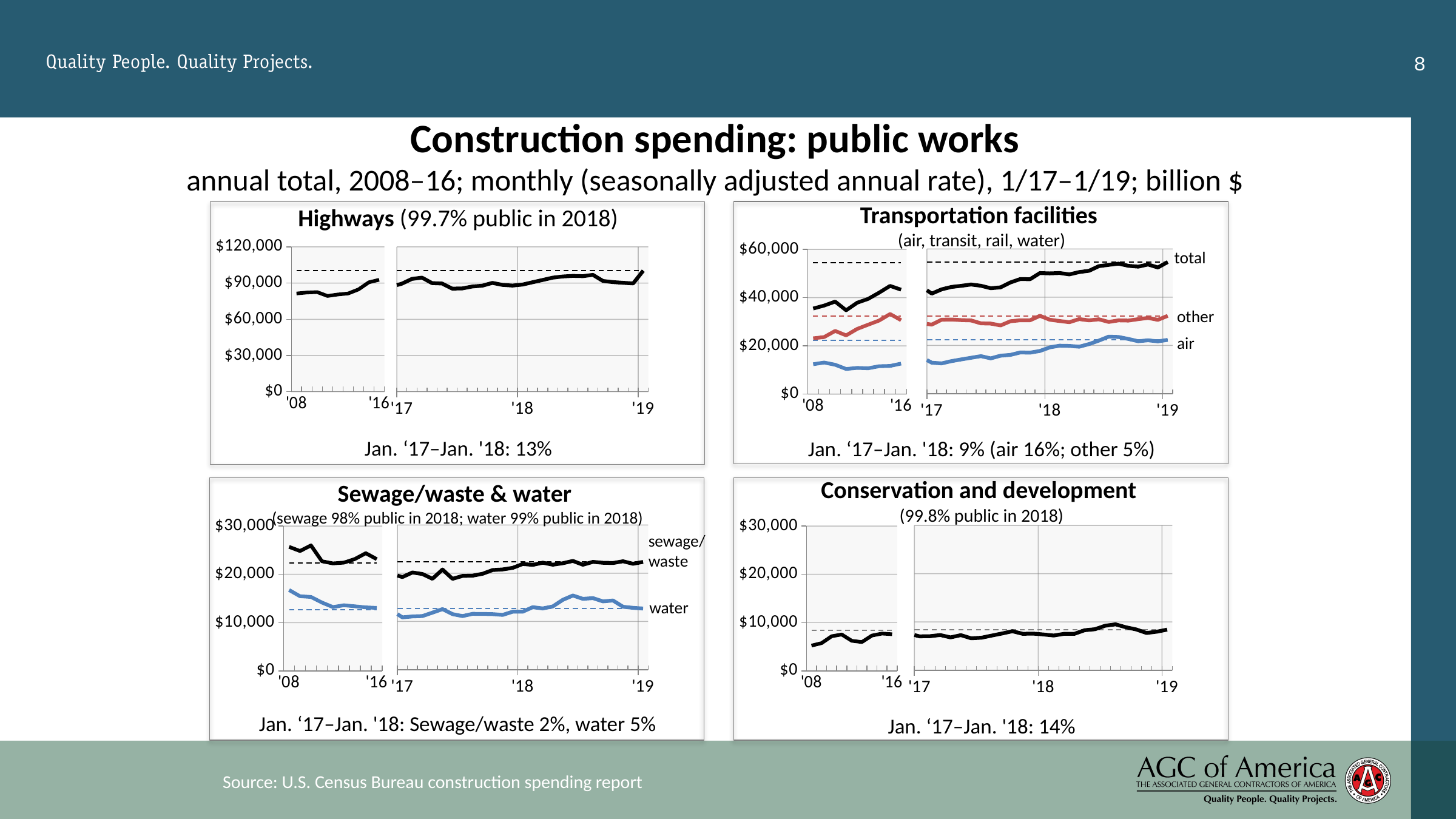
How many series are labelled in the Transportation facilities chart? 3 In the Transportation facilities chart, is the total at Jan. '19 greater or less than $40,000? greater In the Transportation facilities chart, does the total line rise or fall from '17 to '19? rises In the Conservation and development chart, is the value at Jan. '19 greater or less than $10,000? less In the Highways chart, is the value for 2008 greater or less than $90,000? less In the Sewage/waste & water chart, which series is higher throughout, sewage/waste or water? sewage/waste In the Sewage/waste & water chart, does the water line rise or fall from '08 to '16? falls What kind of chart is the Highways chart? line chart According to the caption under the Highways chart, what was the change from Jan. '17 to Jan. '18? 13%